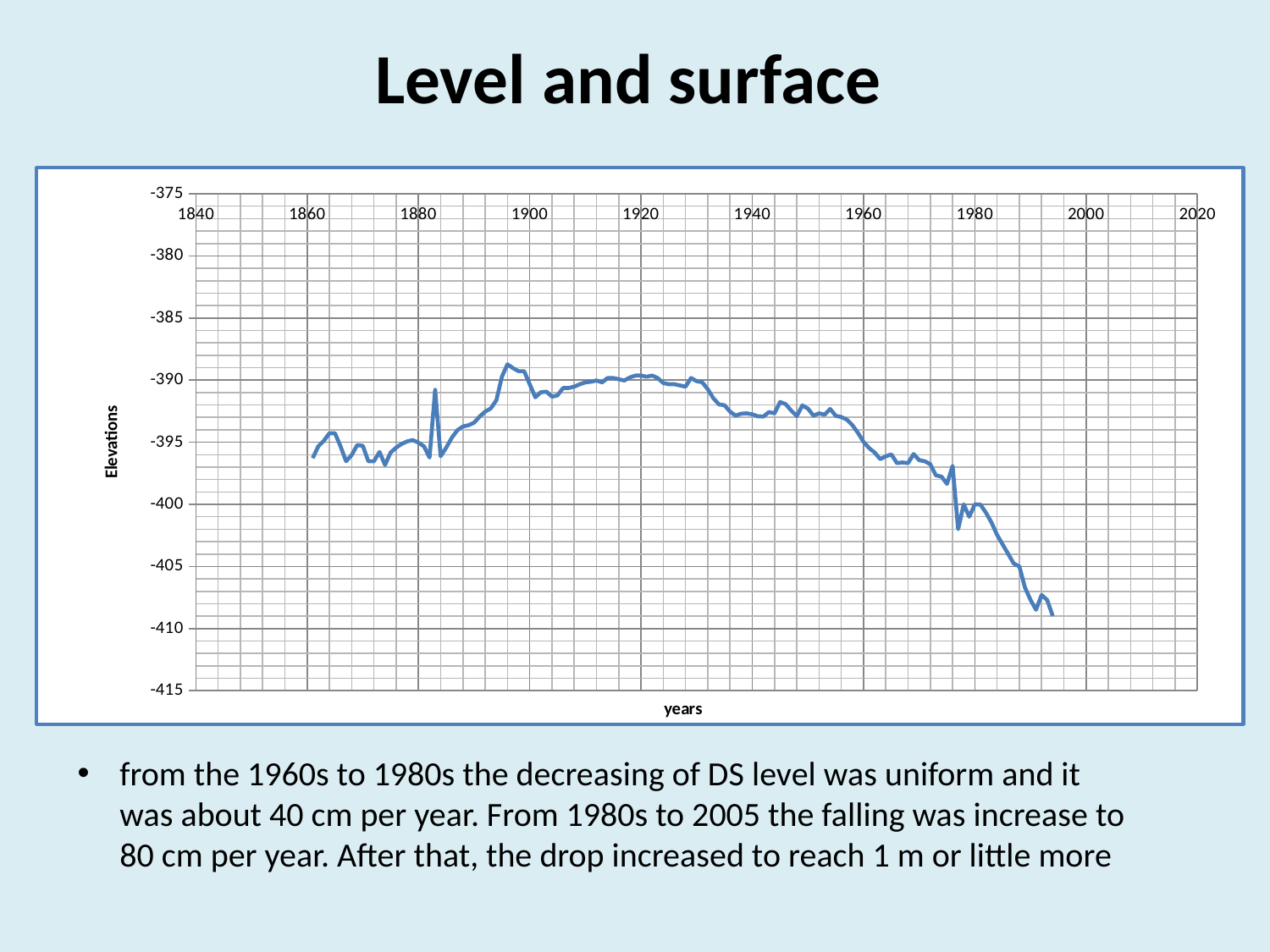
Which is larger, the value plotted around 1900 or the value plotted around 1990? 1900 What kind of chart is shown on the slide? line chart What is the label of the horizontal axis of the chart? years Is the value plotted around the year 1940 greater or less than -395? greater Is the value plotted around the year 1940 greater or less than -390? less What is the label of the vertical axis of the chart? Elevations Do the plotted values rise or fall along the x axis between 1880 and 1900? rise Do the plotted values rise or fall along the x axis between 1930 and 2000? fall How many lines (data series) are plotted on the chart? 1 Is the value plotted around the year 1990 greater or less than -405? less